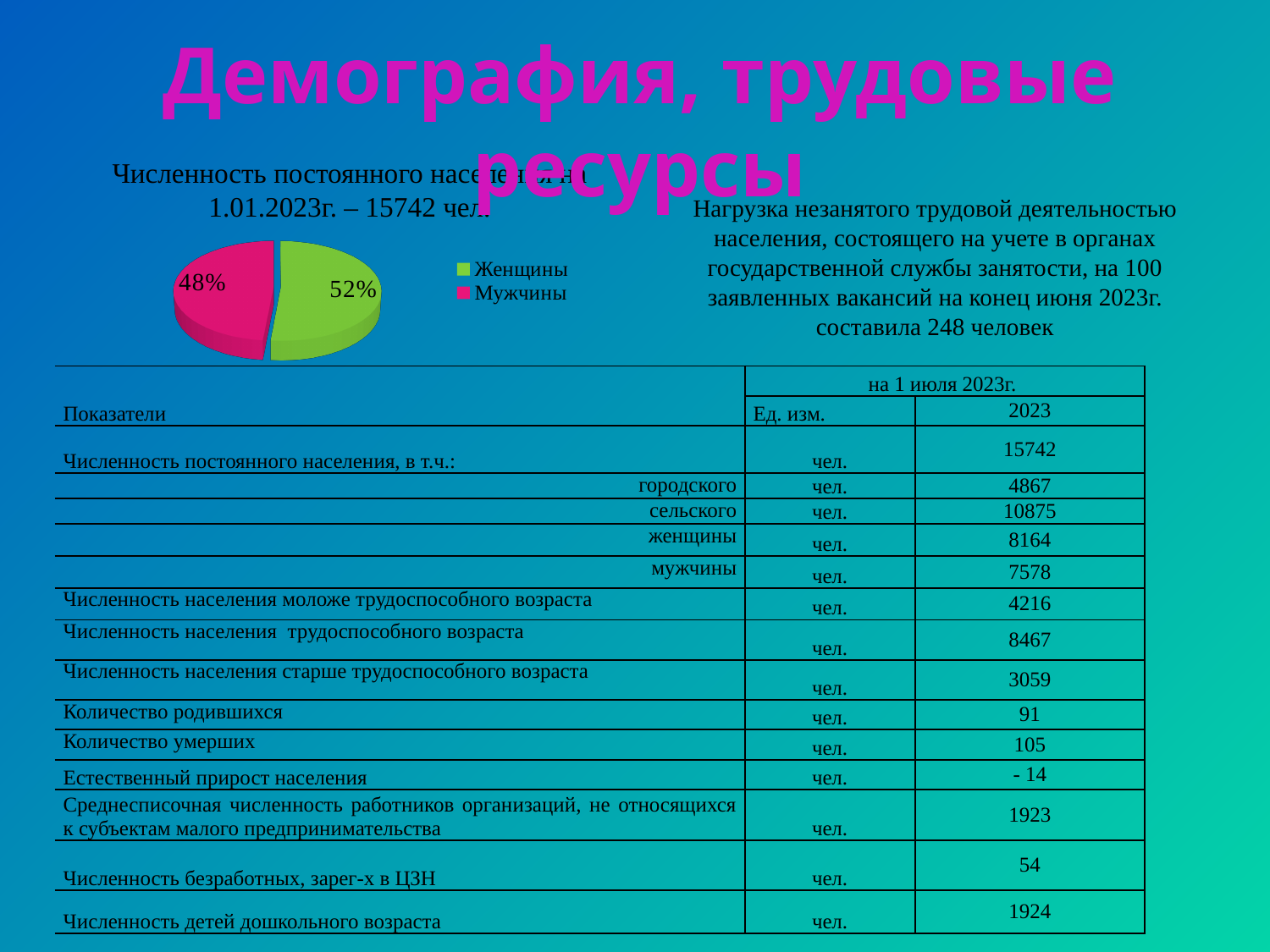
How many entries does the pie chart legend list? 2 Which is larger in the pie chart, the share for Женщины or the share for Мужчины? Женщины In the pie chart, what share is shown for Мужчины? 48% In the pie chart, what share is shown for Женщины? 52% Which slice of the pie chart is the smallest? Мужчины What colour is the Мужчины slice in the pie chart? pink By how many percentage points does the Женщины share exceed the Мужчины share in the pie chart? 4 What colour is the Женщины slice in the pie chart? green What kind of chart is shown on the slide? pie chart How many slices does the pie chart have? 2 What is the total of the two shares shown in the pie chart? 100% Which slice of the pie chart is the largest? Женщины